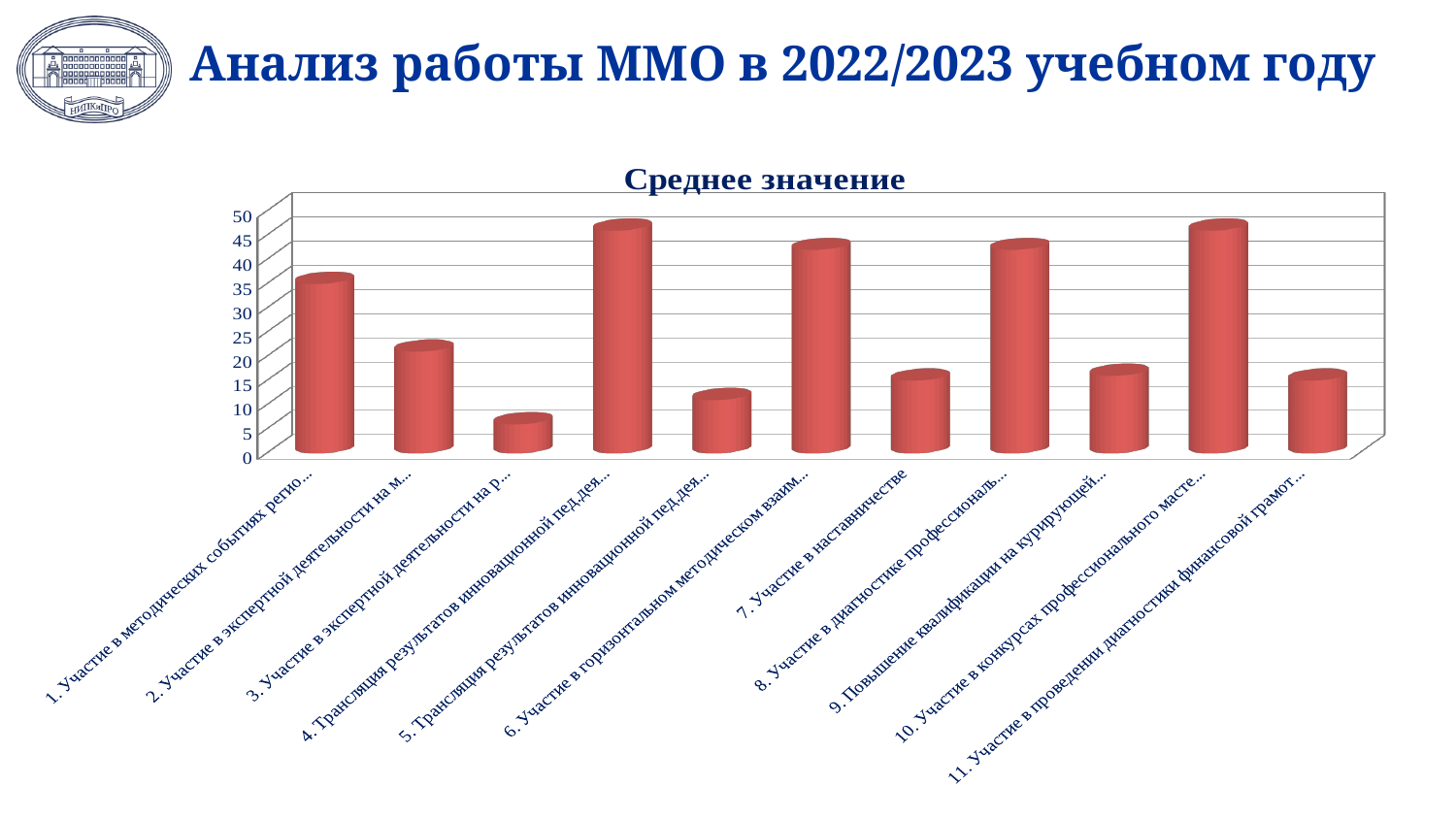
Is the value for category 8 (Участие в диагностике профессиональ...) greater or less than 35? greater What is the title of the chart? Среднее значение Is the value for category 1 (Участие в методических событиях регио...) greater or less than 30? greater How many categories (bars) does the chart show? 11 Which has the larger value: category 1 (Участие в методических событиях регио...) or category 2 (Участие в экспертной деятельности на м...)? category 1 Which has the larger value: category 7 (Участие в наставничестве) or category 8 (Участие в диагностике профессиональ...)? category 8 Is the value for category 7 (Участие в наставничестве) greater or less than 20? less What kind of chart is shown on the slide? bar chart Which category has the lowest value in the chart? 3. Участие в экспертной деятельности на р...